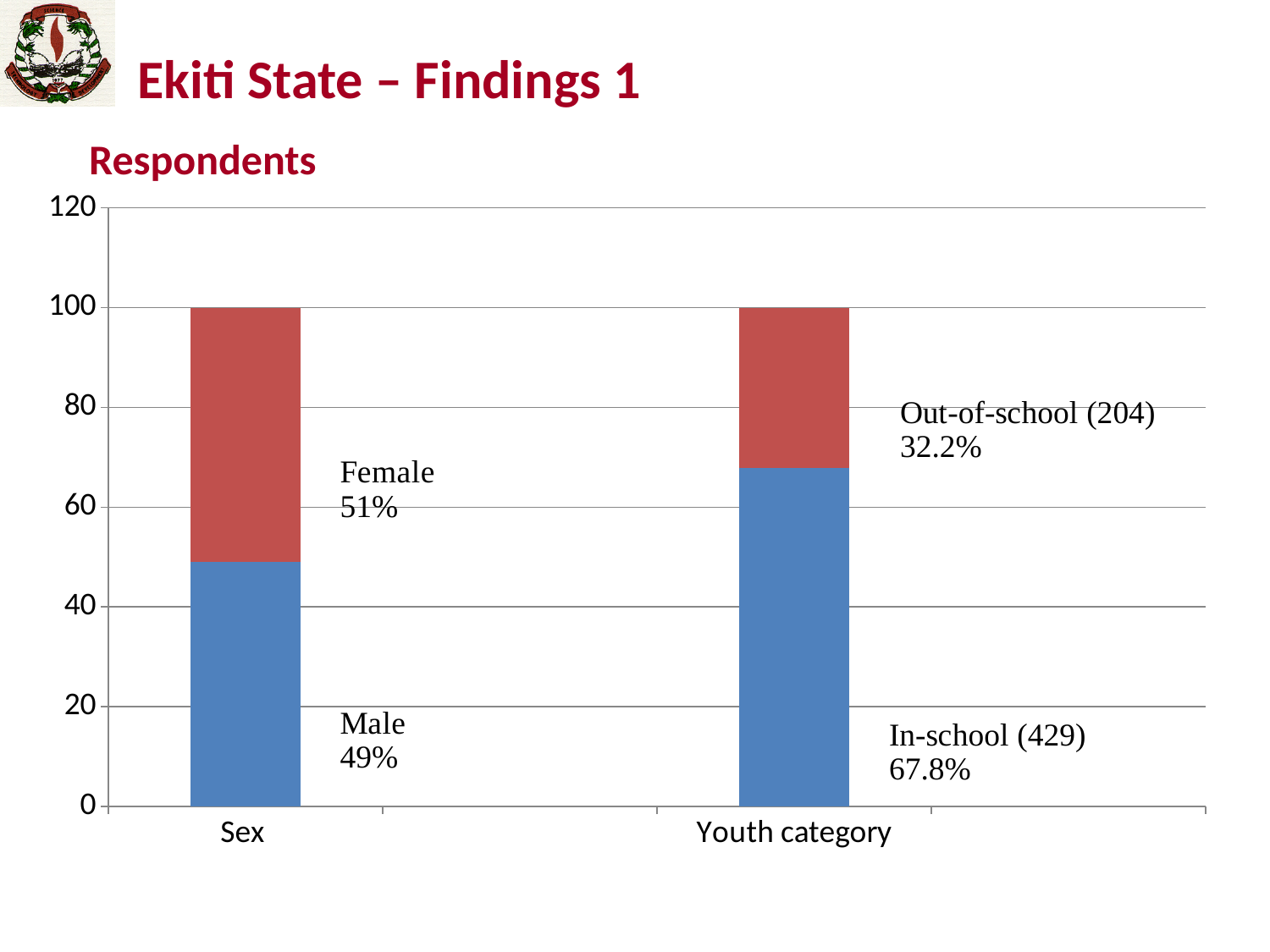
Which is larger, the in-school share or the out-of-school share? In-school What is the difference between the in-school and out-of-school percentages? 35.6% How many out-of-school respondents are there? 204 How many in-school respondents are there? 429 What is the chart's title? Respondents What percentage of respondents are out-of-school youth? 32.2% What kind of chart is shown on the slide? stacked bar chart What percentage of respondents are male? 49% How many categories are shown on the x axis? 2 Is the value for Male greater or less than 60? less What percentage of respondents are female? 51% What percentage of respondents are in-school youth? 67.8%